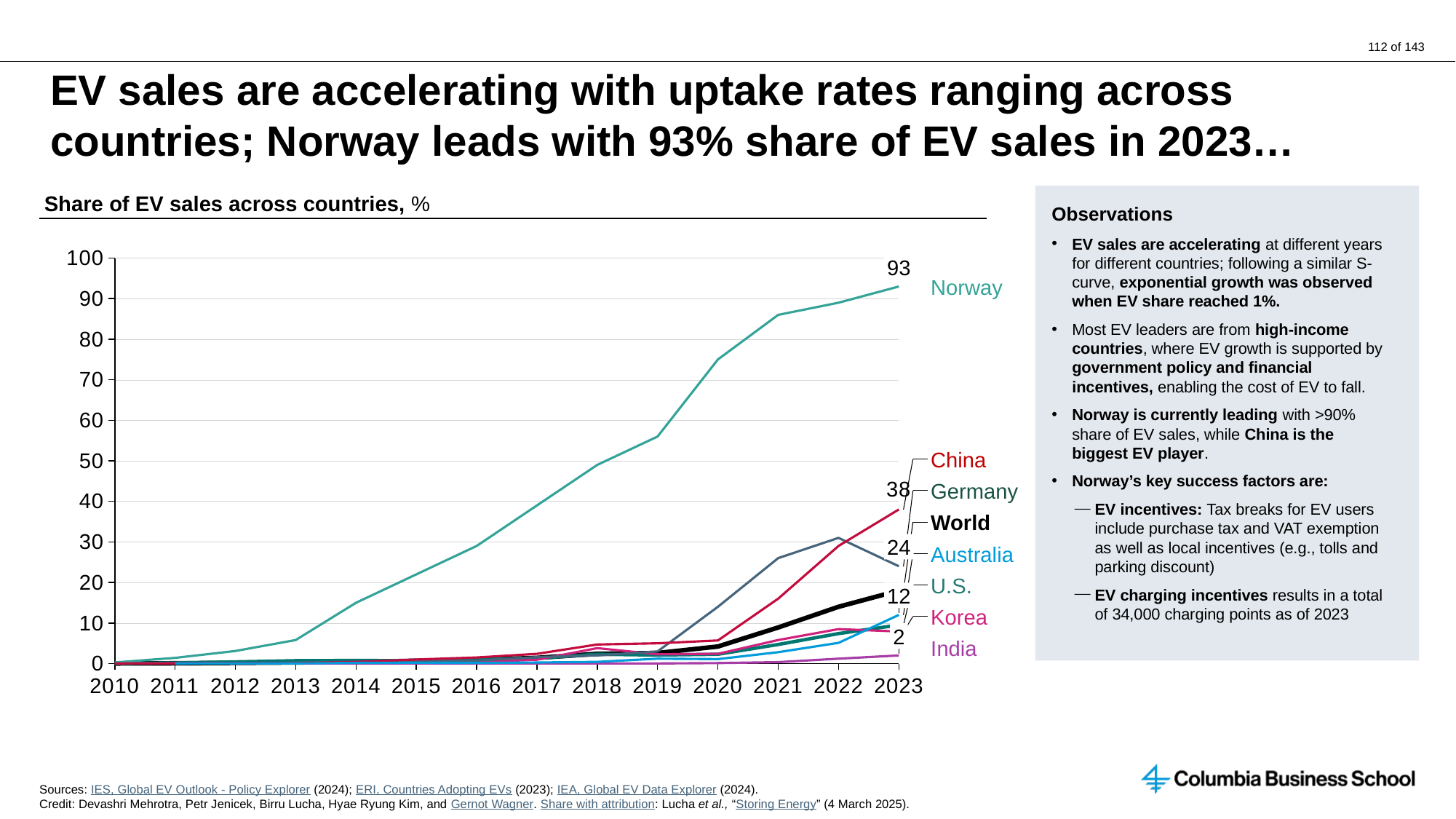
What is China's share of EV sales in 2023? 38 What is Norway's share of EV sales in 2023? 93 What kind of chart is shown on the slide? line chart What is the title of the chart? Share of EV sales across countries, % Which country has the highest share of EV sales in 2023? Norway How many series are labelled on the chart? 8 Which series has the lowest share of EV sales in 2023? India What is India's share of EV sales in 2023? 2 What is the difference between Norway's and China's share of EV sales in 2023? 55 How many years are shown on the x axis? 14 Does Norway's share of EV sales rise or fall from 2010 to 2023? rise Is Norway's share of EV sales in 2019 greater or less than 50? greater